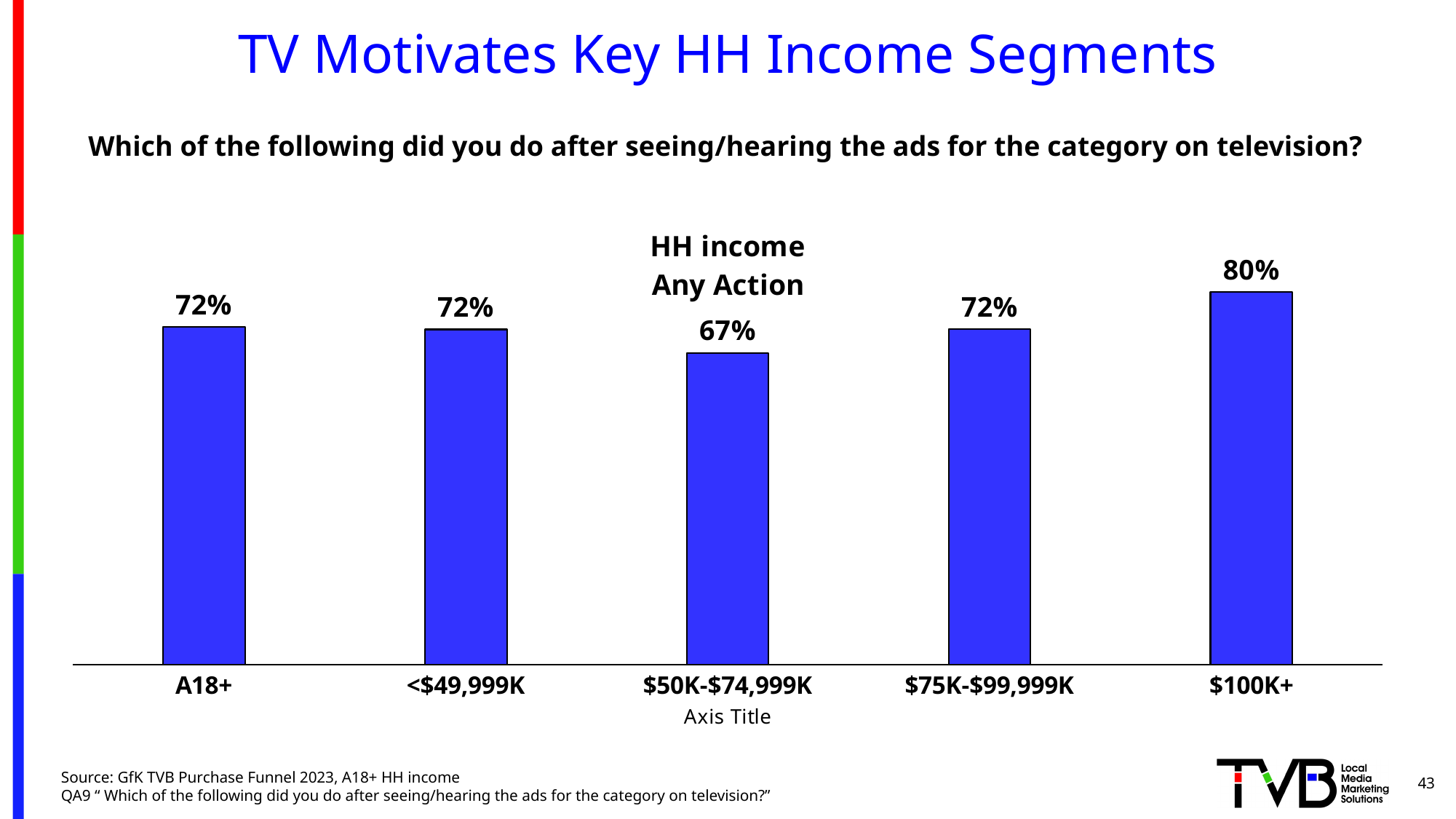
What is the value for <$49,999K? 72% What is the value for $100K+? 80% What is the value for $50K-$74,999K? 67% What is the value for A18+? 72% What is the difference between the values for $100K+ and $50K-$74,999K? 13% What kind of chart is shown on the slide? Bar chart Which category has the lowest value? $50K-$74,999K Which is larger, the value for $100K+ or the value for $75K-$99,999K? $100K+ Which category has the highest value? $100K+ What is the title of the chart? HH income Any Action How many categories are shown on the chart? 5 What is the difference between the values for $100K+ and $75K-$99,999K? 8%